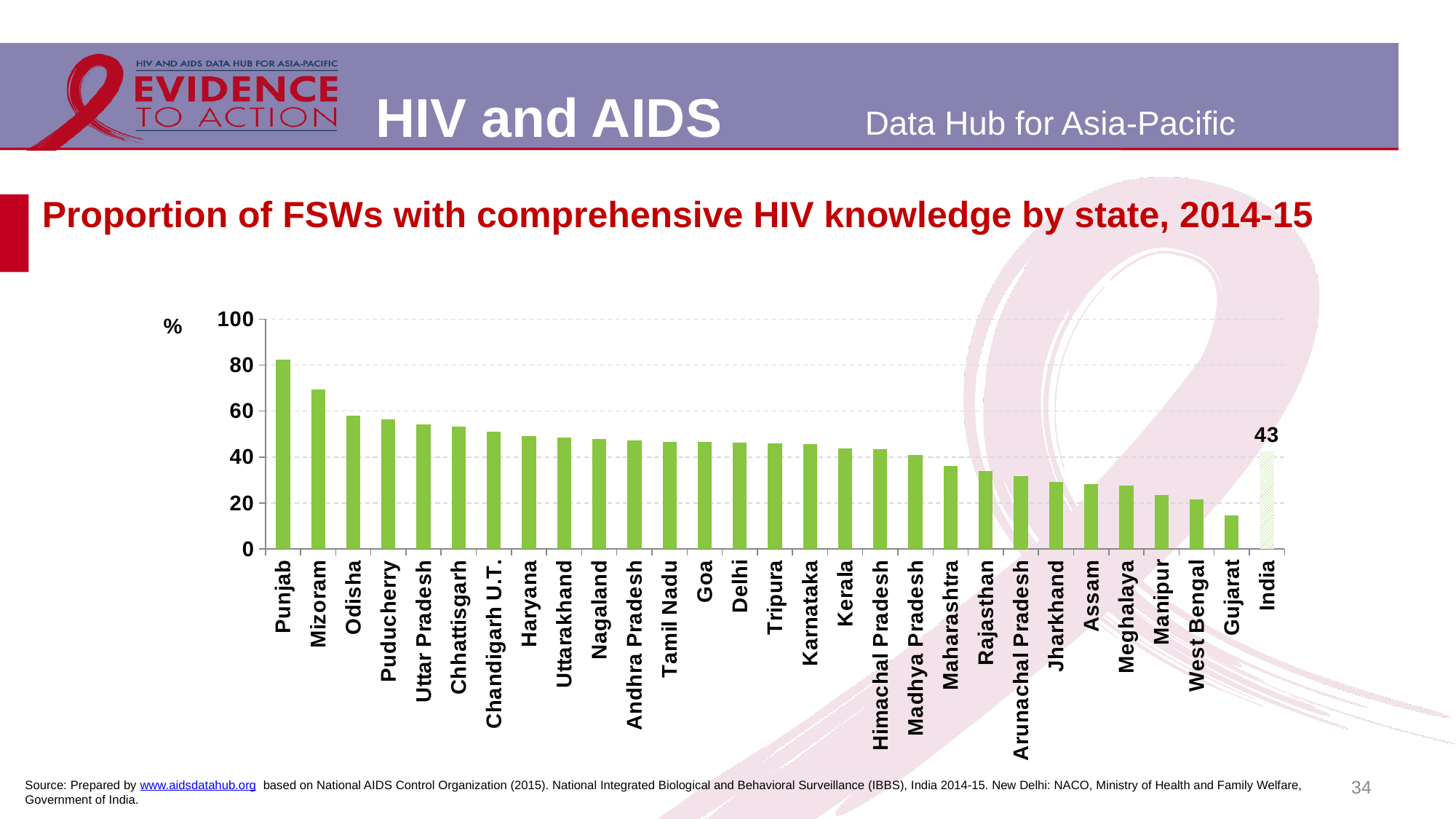
Do the bar values rise or fall from left to right along the x axis? fall How many bars are plotted on the chart? 29 Which has a higher value, Punjab or Mizoram? Punjab Which has a higher value, Maharashtra or Gujarat? Maharashtra Is the value for Punjab greater or less than 60? greater Which state has the lowest proportion of FSWs with comprehensive HIV knowledge? Gujarat Is the value for Gujarat greater or less than 20? less Is the value for Assam greater or less than 40? less What kind of chart is shown on the slide? bar chart Which state has the highest proportion of FSWs with comprehensive HIV knowledge? Punjab What is the value printed for India? 43